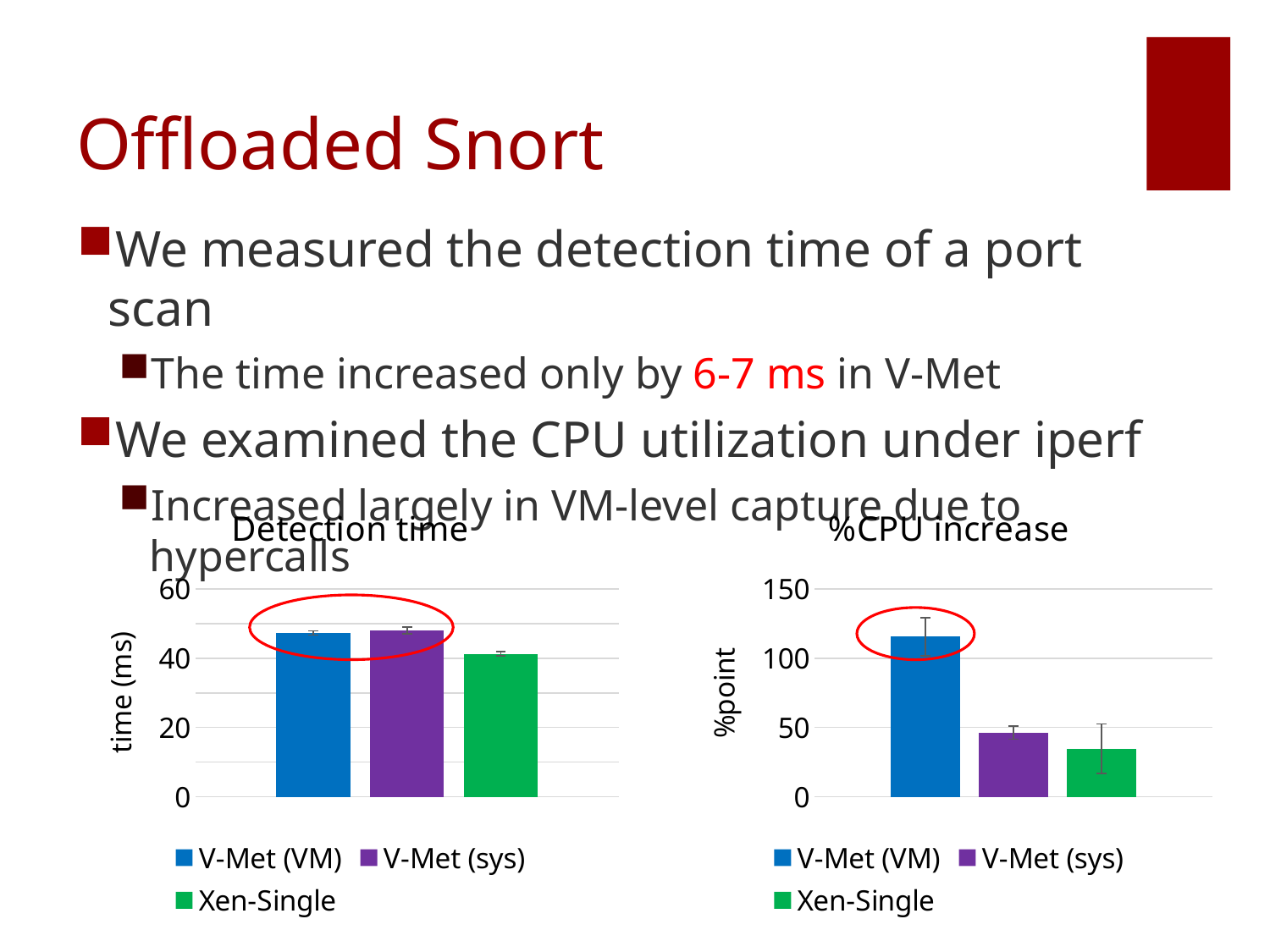
How many bars are plotted in the Detection time chart? 3 What kind of chart is the Detection time chart? bar chart In the Detection time chart, which series has the lowest value? Xen-Single In the %CPU increase chart, which is larger, V-Met (sys) or Xen-Single? V-Met (sys) In the Detection time chart, is the value for V-Met (VM) greater or less than 40? greater What is the y-axis label of the Detection time chart? time (ms) What is the y-axis label of the %CPU increase chart? %point In the Detection time chart, is the value for Xen-Single greater or less than 60? less In the %CPU increase chart, which series has the highest value? V-Met (VM) In the %CPU increase chart, is the value for V-Met (VM) greater or less than 100? greater How many series does the legend of the %CPU increase chart list? 3